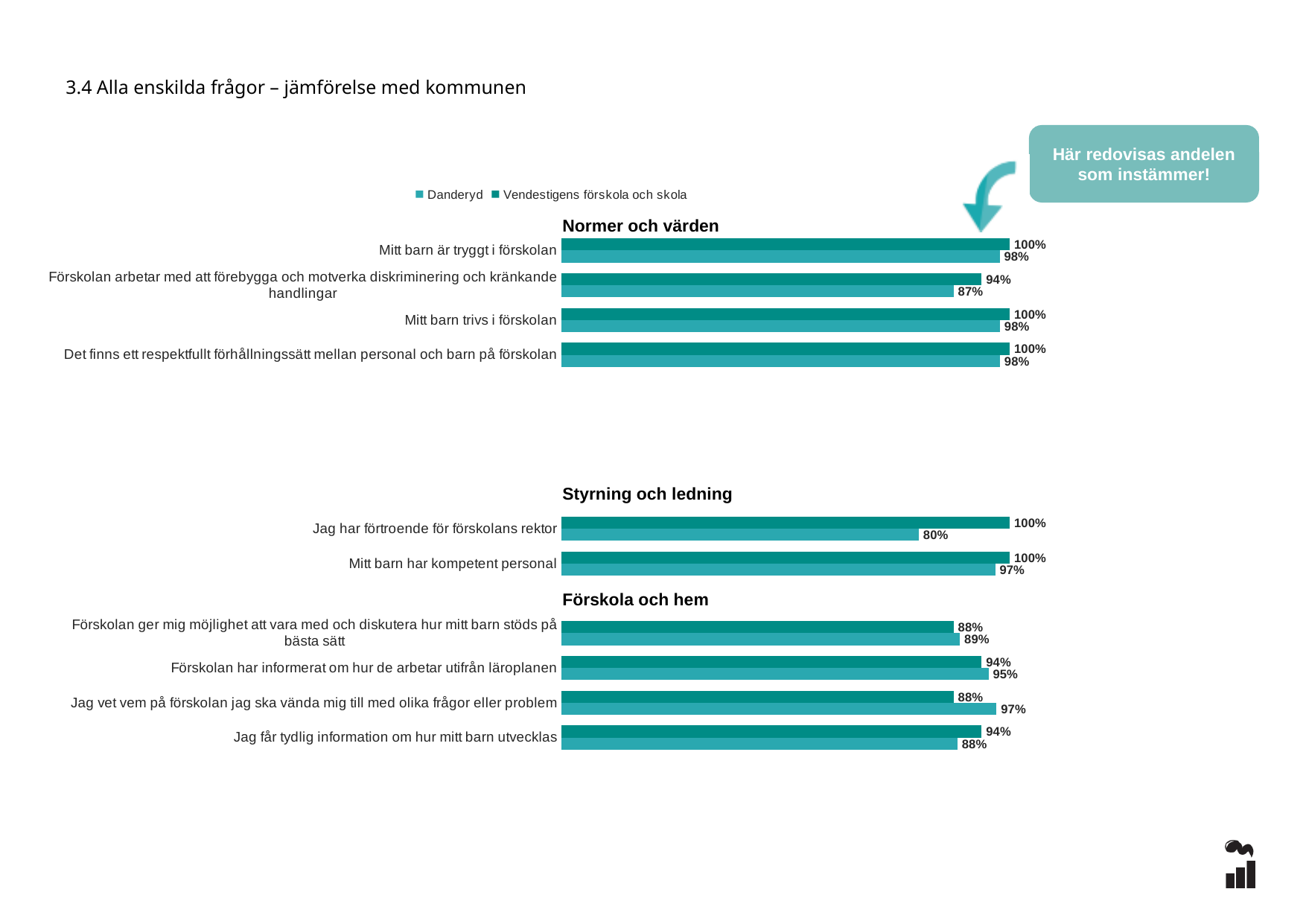
In the 'Styrning och ledning' chart, what are the two values shown for 'Jag har förtroende för förskolans rektor'? 100% and 80% In the 'Förskola och hem' chart, what is the difference between the two values for 'Jag vet vem på förskolan jag ska vända mig till med olika frågor eller problem'? 9 percentage points How many series does the legend list? 2 In the 'Förskola och hem' chart, what are the two values shown for 'Förskolan har informerat om hur de arbetar utifrån läroplanen'? 94% and 95% In the 'Normer och värden' chart, how many categories are shown? 4 In the 'Förskola och hem' chart, how many categories are shown? 4 Which two series are listed in the legend? Danderyd and Vendestigens förskola och skola In the 'Styrning och ledning' chart, is the lower bar for 'Jag har förtroende för förskolans rektor' larger or smaller than the lower bar for 'Mitt barn har kompetent personal'? Smaller In the 'Förskola och hem' chart, which category has the lowest value for the lower (lighter) bar? Jag får tydlig information om hur mitt barn utvecklas In the 'Styrning och ledning' chart, what is the difference between the two values for 'Jag har förtroende för förskolans rektor'? 20 percentage points In the 'Normer och värden' chart, what are the two values shown for 'Förskolan arbetar med att förebygga och motverka diskriminering och kränkande handlingar'? 94% and 87% What kind of chart is used on this slide? Bar chart